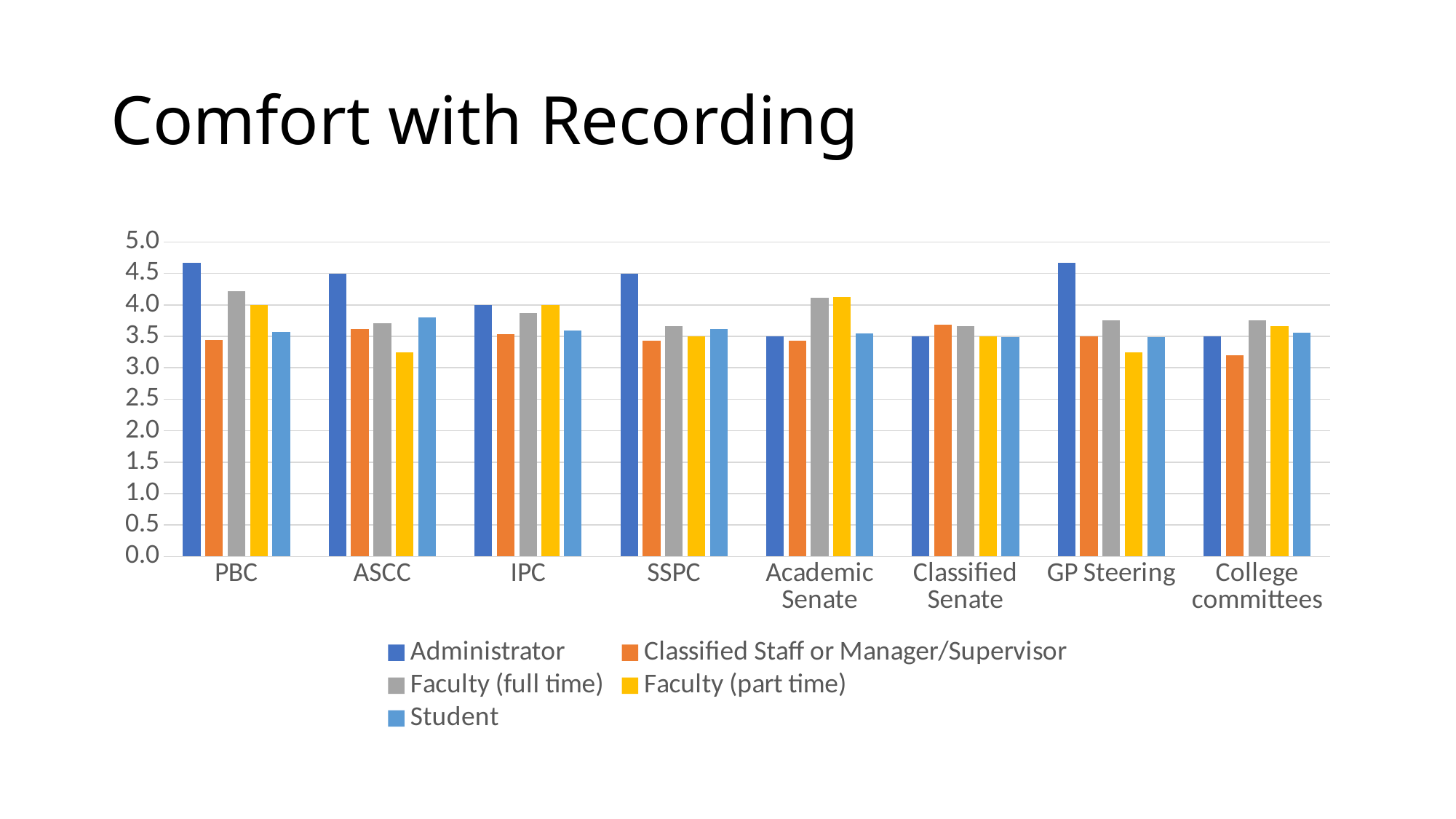
Is the Administrator value for GP Steering greater or less than 4.5? greater Which series has the highest value for PBC? Administrator Is the Faculty (part time) value for ASCC greater or less than 3.5? less How many series does the legend list? 5 How many committee categories are shown on the x axis? 8 Is the Classified Staff or Manager/Supervisor value for College committees greater or less than 3.5? less What kind of chart is shown on the slide? bar chart Which series has the lowest value for College committees? Classified Staff or Manager/Supervisor For ASCC, which is larger: the Faculty (full time) value or the Faculty (part time) value? Faculty (full time) What is the title of the slide? Comfort with Recording For SSPC, which is larger: the Administrator value or the Student value? Administrator